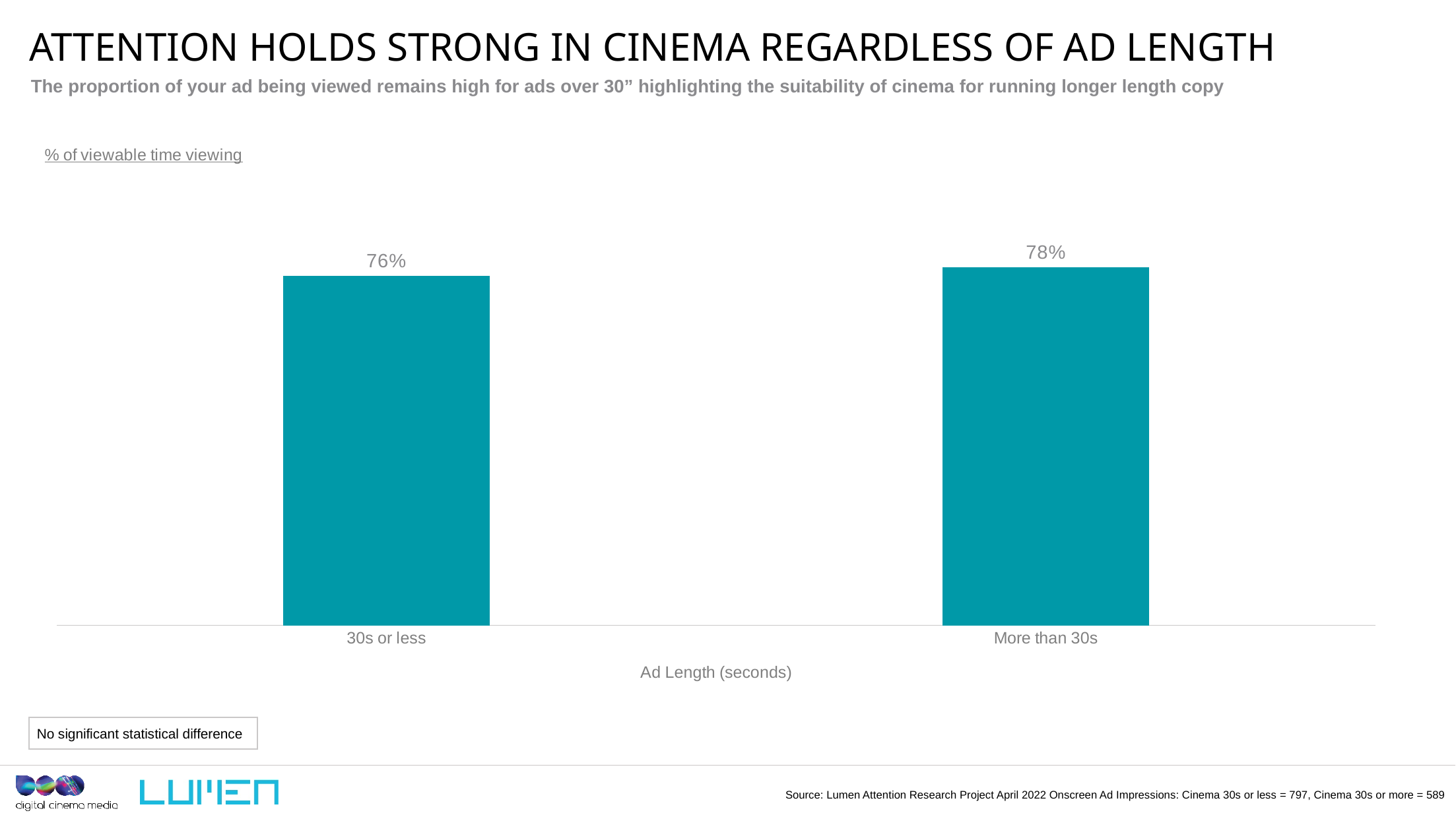
Do the values rise or fall from '30s or less' to 'More than 30s'? rise Which ad length category has the higher % of viewable time viewing? More than 30s How many ad length categories are shown in the chart? 2 Is the value for 'More than 30s' larger or smaller than the value for '30s or less'? larger Which ad length category has the lower % of viewable time viewing? 30s or less What is the % of viewable time viewing for ads of 30s or less? 76% What is the difference in % of viewable time viewing between 'More than 30s' and '30s or less'? 2% What does the chart measure, according to the label above it? % of viewable time viewing What kind of chart is shown on the slide? bar chart What is the % of viewable time viewing for ads of more than 30s? 78% What is the label of the x axis of the chart? Ad Length (seconds)